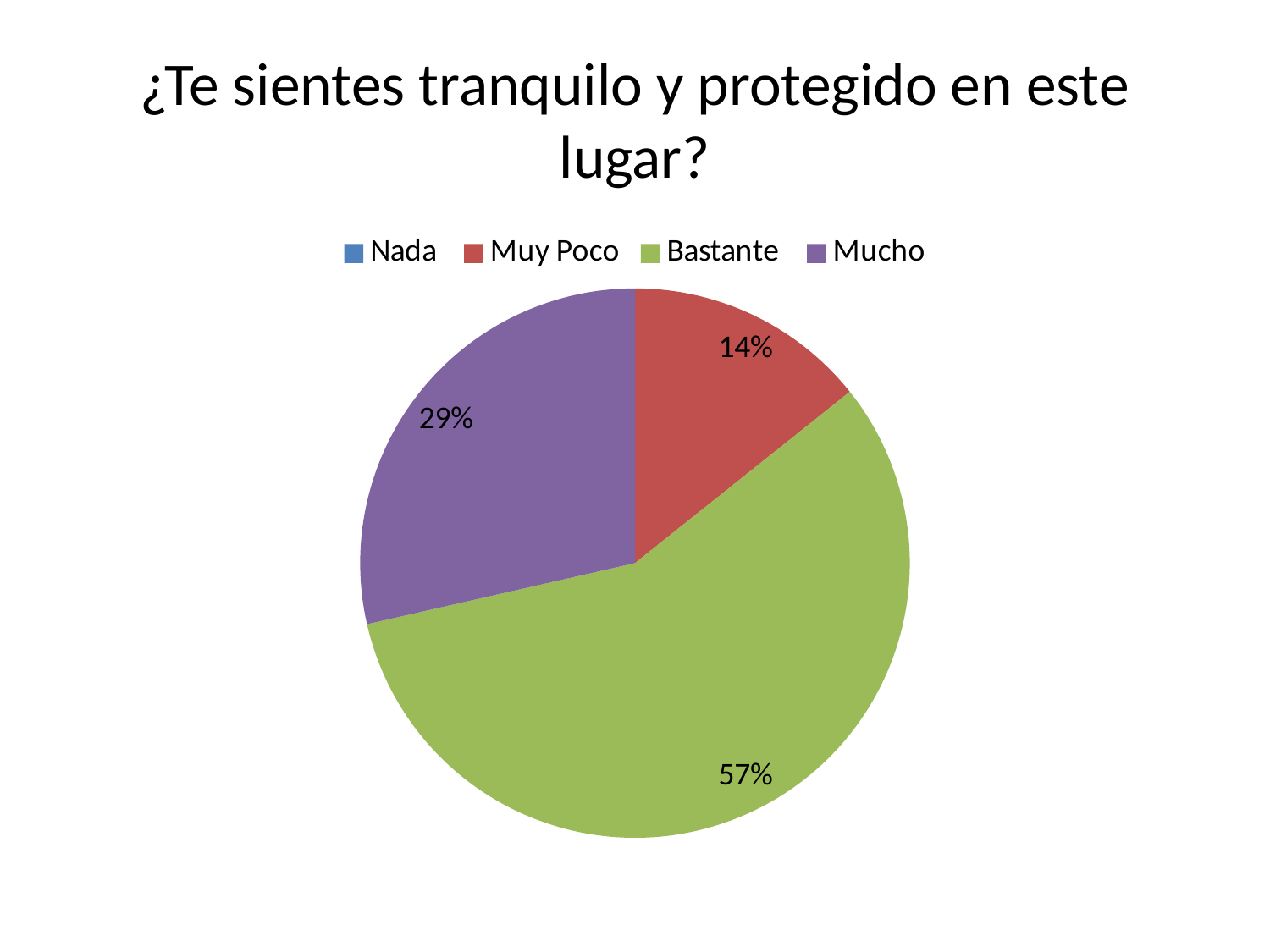
What share of the pie does Muy Poco represent? 14% Which is larger, the share for Mucho or the share for Muy Poco? Mucho What kind of chart is shown on the slide? Pie chart What is the title of the chart? ¿Te sientes tranquilo y protegido en este lugar? What share of the pie does Bastante represent? 57% Which category with a visible slice has the smallest share? Muy Poco What is the difference in percentage points between Bastante and Mucho? 28 Which category has the largest slice of the pie? Bastante What colour is the Bastante slice? Green What is the difference in percentage points between Mucho and Muy Poco? 15 What share of the pie does Mucho represent? 29% How many categories does the legend list? 4